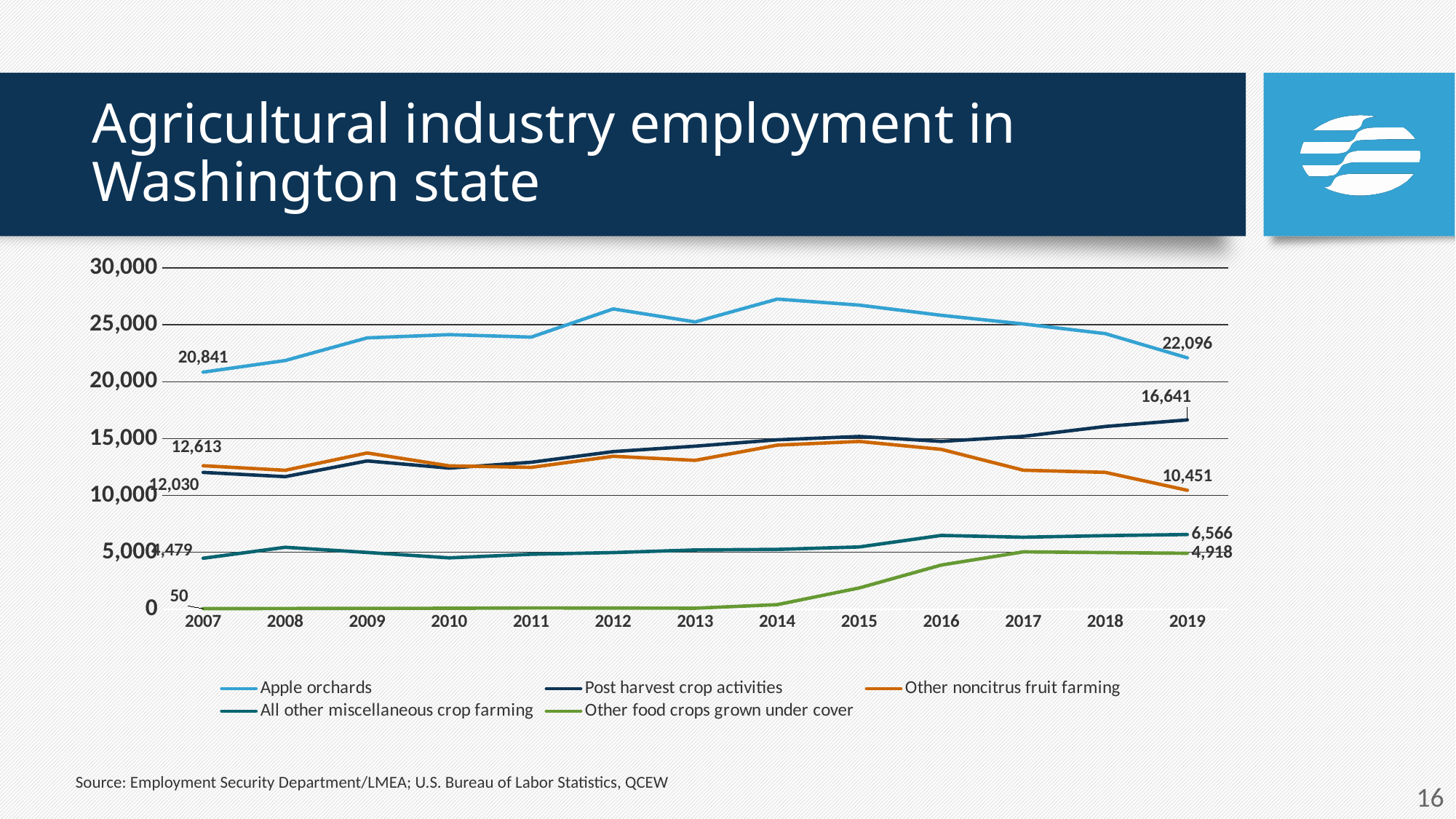
Which series has the highest value in 2019? Apple orchards In 2019, which is larger: Post harvest crop activities or Other noncitrus fruit farming? Post harvest crop activities What is the difference between Post harvest crop activities in 2019 and in 2007? 4,611 What is the value for Other noncitrus fruit farming in 2007? 12,613 How many years are plotted along the x axis? 13 What kind of chart is shown on the slide? line chart What is the value for Post harvest crop activities in 2019? 16,641 What is the value for Other food crops grown under cover in 2007? 50 Is the value for Apple orchards in 2014 greater or less than 25,000? greater By how much did Apple orchards employment change from 2007 (20,841) to 2019 (22,096)? 1,255 How many series does the legend list? 5 What is the value for Apple orchards in 2019? 22,096